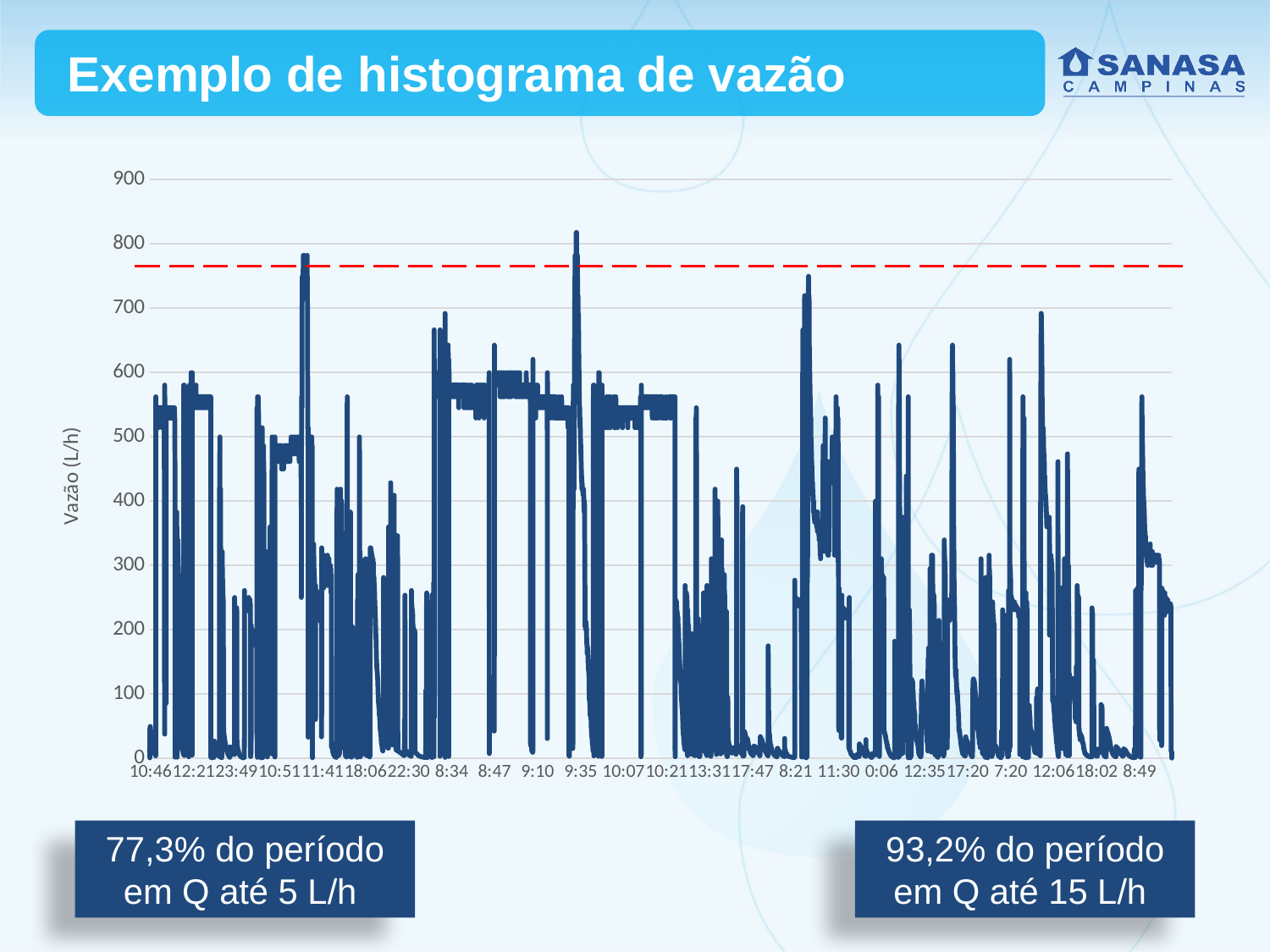
According to the text box on the left below the chart, what percentage of the period has Q up to 5 L/h? 77,3% What is the last time label shown on the horizontal axis of the chart? 8:49 What is the highest value shown on the vertical axis of the chart? 900 According to the text box on the right below the chart, what percentage of the period has Q up to 15 L/h? 93,2% Is the red dashed horizontal line on the chart greater or less than 700 L/h? greater What is the lowest value shown on the vertical axis of the chart? 0 What is the first time label shown on the horizontal axis of the chart? 10:46 Is the red dashed horizontal line on the chart greater or less than 800 L/h? less What is the label of the vertical axis of the chart? Vazão (L/h) What kind of chart is shown on the slide? line chart Is the highest peak of the plotted flow greater or less than 700 L/h? greater What is the title of the chart on the slide? Exemplo de histograma de vazão